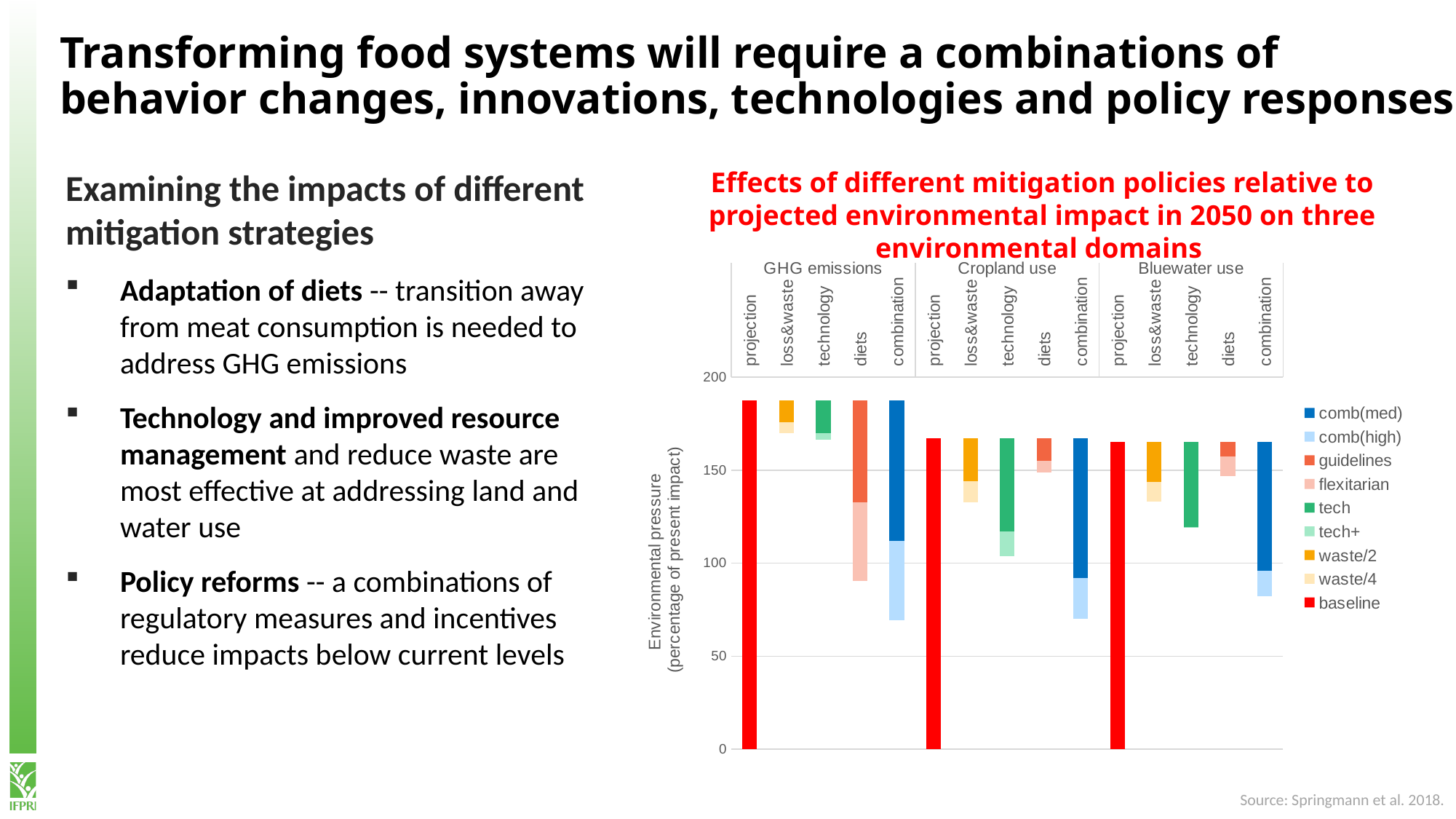
Is the baseline projection bar for GHG emissions taller than the baseline projection bar for Bluewater use? Yes Is the lower end of the tech bar for Bluewater use greater or less than 100? greater How many mitigation categories are shown within each environmental domain on the chart? 5 Which legend entry is shown in red on the chart? baseline What is the label of the chart's vertical axis? Environmental pressure (percentage of present impact) Is the baseline projection value for GHG emissions greater or less than 150? greater Is the baseline projection value for Cropland use greater or less than 150? greater Which environmental domain has the highest baseline (projection) bar? GHG emissions How many series does the chart legend list? 9 How many environmental domains are shown along the x axis of the chart? 3 What kind of chart is shown on the slide? bar chart